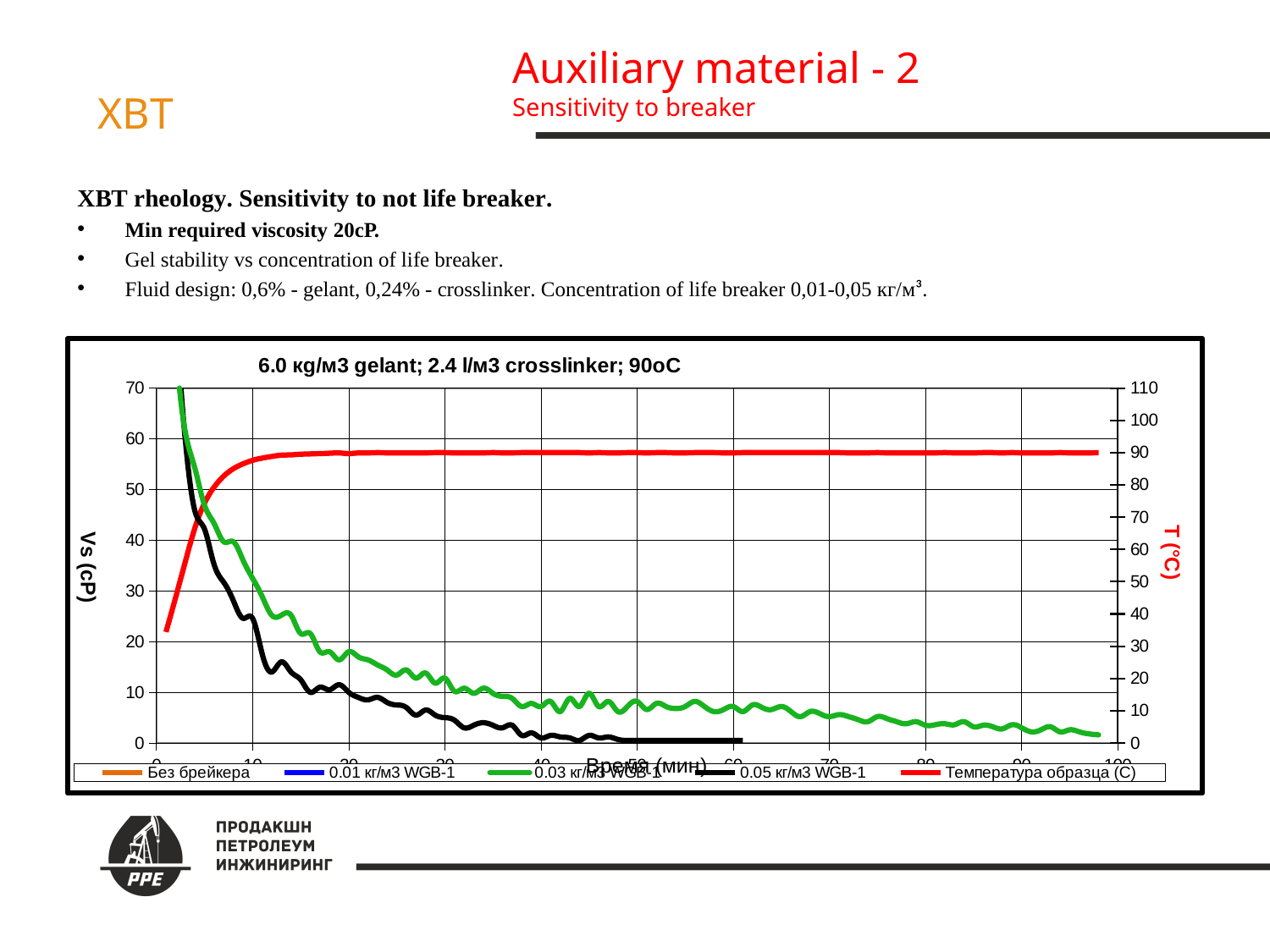
Is the sample temperature (Температура образца) at 40 minutes greater or less than 80 °C? greater At 30 minutes, which series has the higher viscosity: 0.03 кг/м3 WGB-1 or 0.05 кг/м3 WGB-1? 0.03 кг/м3 WGB-1 What is the label of the left vertical axis of the chart? Vs (cP) How many series does the chart legend list? 5 Does the viscosity of the 0.03 кг/м3 WGB-1 series rise or fall as time increases? fall Is the viscosity of the 0.05 кг/м3 WGB-1 series at 10 minutes greater or less than 20 cP? greater What kind of chart is shown on the slide? line chart Is the viscosity of the 0.05 кг/м3 WGB-1 series at 30 minutes greater or less than 10 cP? less Does the viscosity of the 0.05 кг/м3 WGB-1 series rise or fall as time increases? fall What is the title of the chart? 6.0 кg/м3 gelant; 2.4 l/м3 crosslinker; 90oC